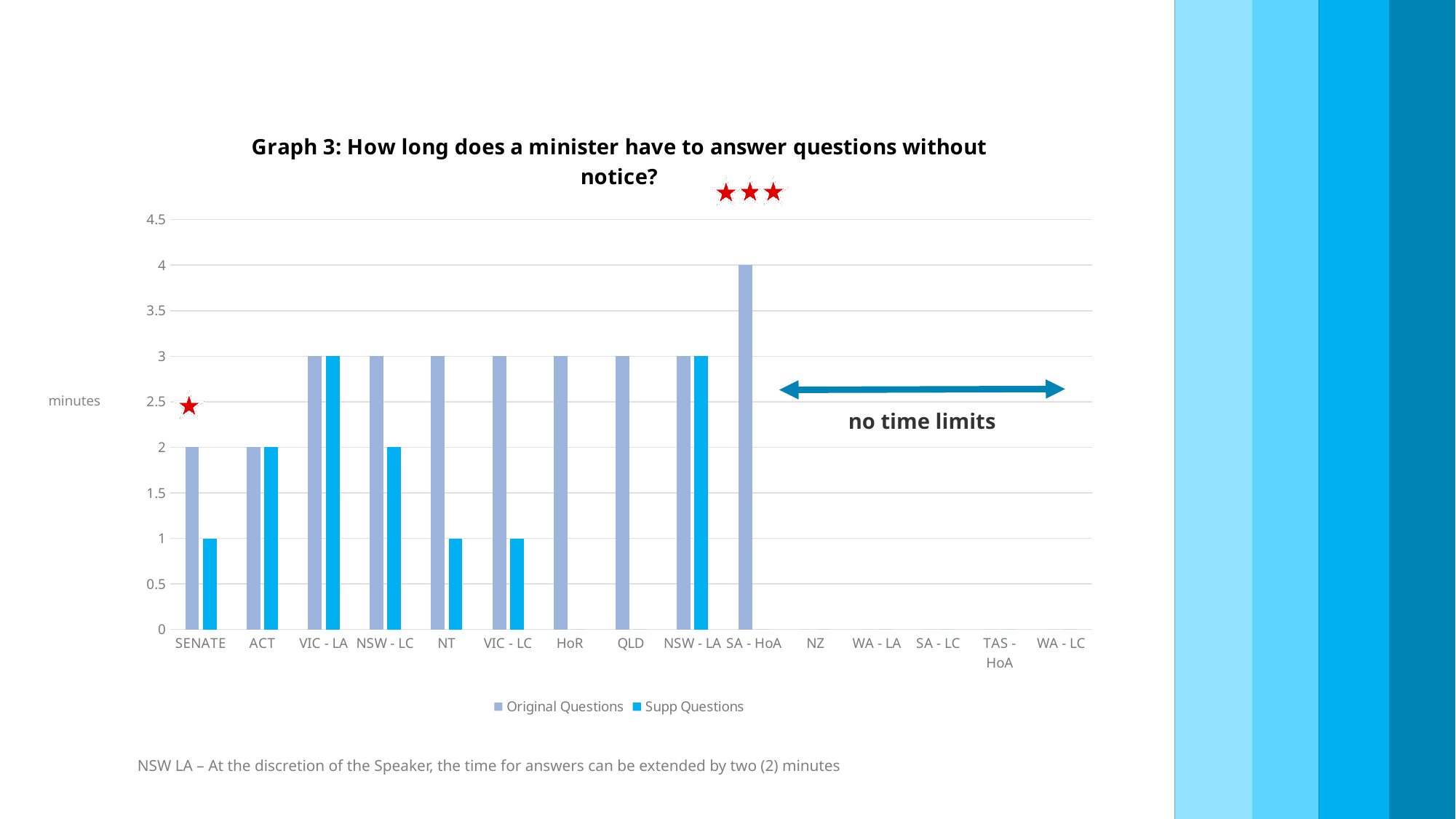
Which category has the highest value for Original Questions? SA - HoA Which is larger for ACT: the Original Questions value or the Supp Questions value? They are equal What is the title of the chart? Graph 3: How long does a minister have to answer questions without notice? How many series does the legend list? 2 What is the Original Questions value for SA - HoA? 4 How many categories are shown on the x axis? 15 What kind of chart is shown on the slide? bar chart What is the difference between the Original Questions and Supp Questions values for VIC - LC? 2 Is the Original Questions value for SA - HoA greater or less than 3.5? greater What is the Supp Questions value for NT? 1 What is the Original Questions value for NSW - LC? 3 What is the Supp Questions value for SENATE? 1